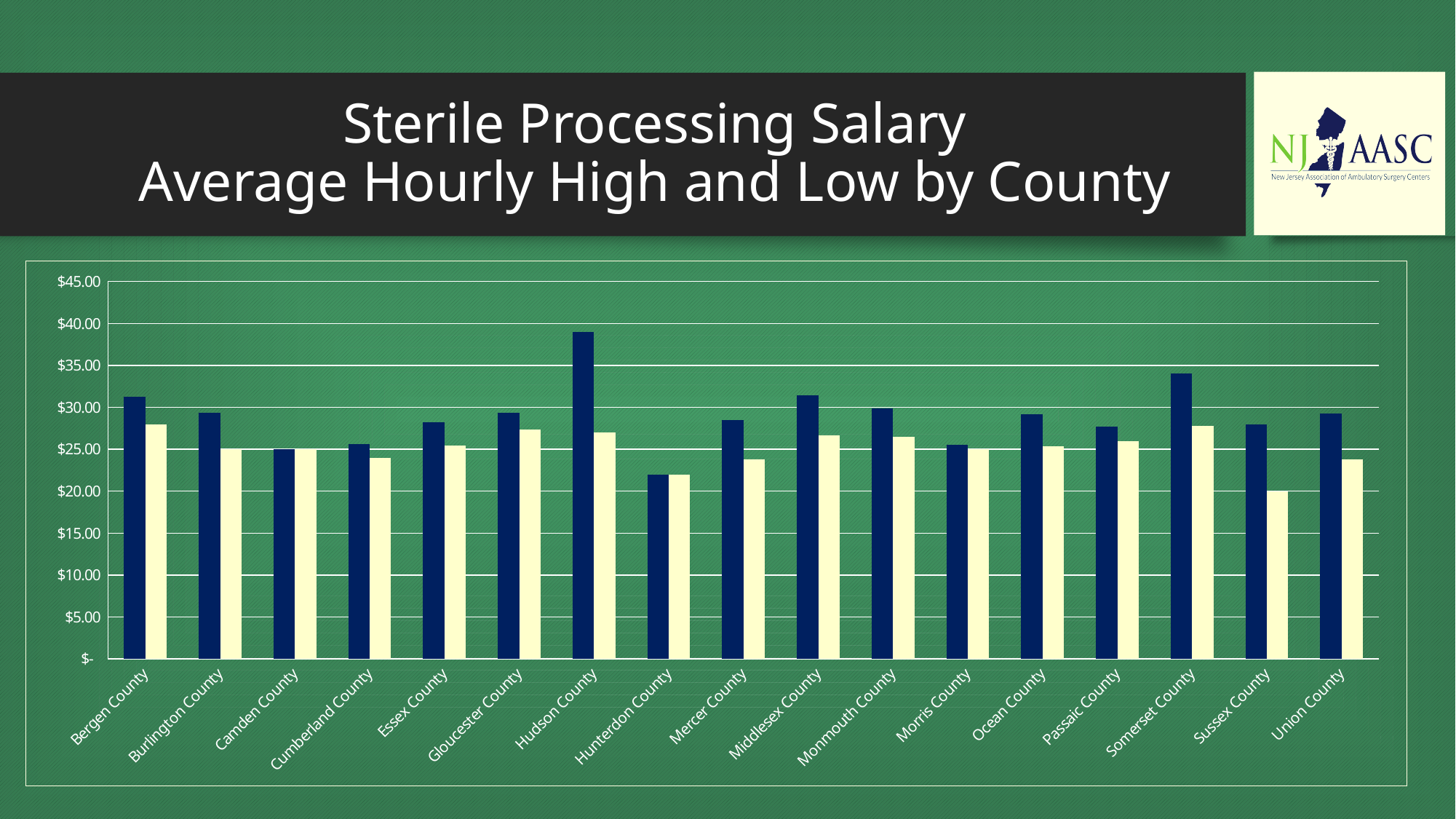
What is the title of the chart? Sterile Processing Salary Average Hourly High and Low by County Which county has the shortest light yellow bar? Sussex County How many bars are plotted for each county? 2 Which is larger, the dark blue bar for Hudson County or the dark blue bar for Somerset County? Hudson County Which county has the tallest dark blue bar? Hudson County What kind of chart is shown on the slide? Bar chart Which county has the shortest dark blue bar? Hunterdon County How many counties are shown on the x axis? 17 Is the dark blue bar for Hunterdon County greater or less than $25.00? less Is the dark blue bar for Hudson County greater or less than $35.00? greater Which is larger, the light yellow bar for Sussex County or the light yellow bar for Union County? Union County Is the light yellow bar for Sussex County greater or less than $25.00? less